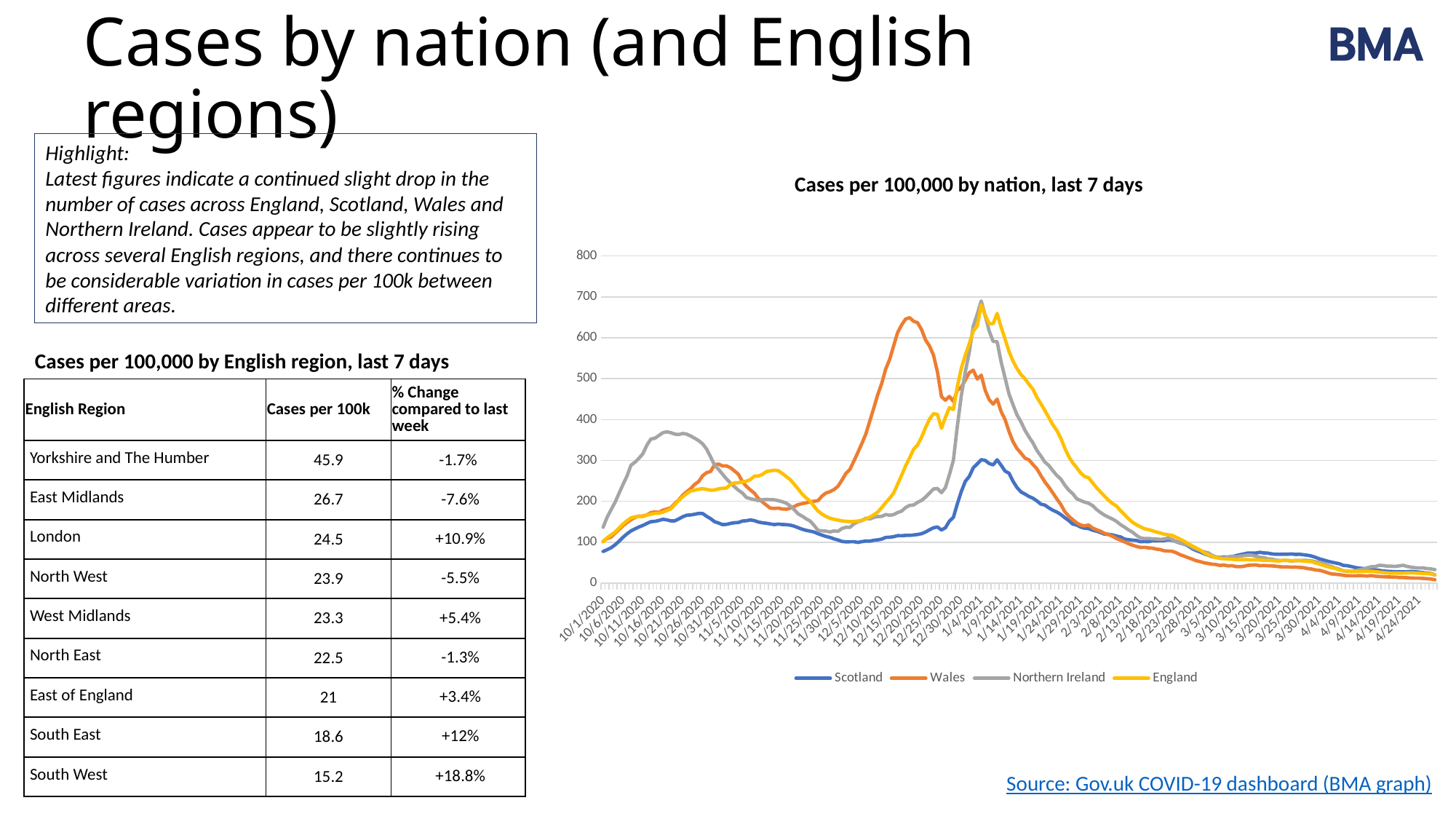
What is the title of the chart? Cases per 100,000 by nation, last 7 days Do the values for all four nations rise or fall between 1/9/2021 and 4/24/2021? fall Is the peak value for Wales around 12/20/2020 greater or less than 600? greater Which nations are listed in the chart's legend? Scotland, Wales, Northern Ireland, England Which nation had the lowest peak value in the chart? Scotland Are the values for all four nations at 4/24/2021 greater or less than 100? less What kind of chart is shown on the slide? line chart Around 12/20/2020, which is larger: the value for Wales or the value for Scotland? Wales Is the peak value for Scotland in early January 2021 greater or less than 400? less Around 10/21/2020, which is larger: the value for Northern Ireland or the value for Scotland? Northern Ireland How many series does the legend of the chart list? 4